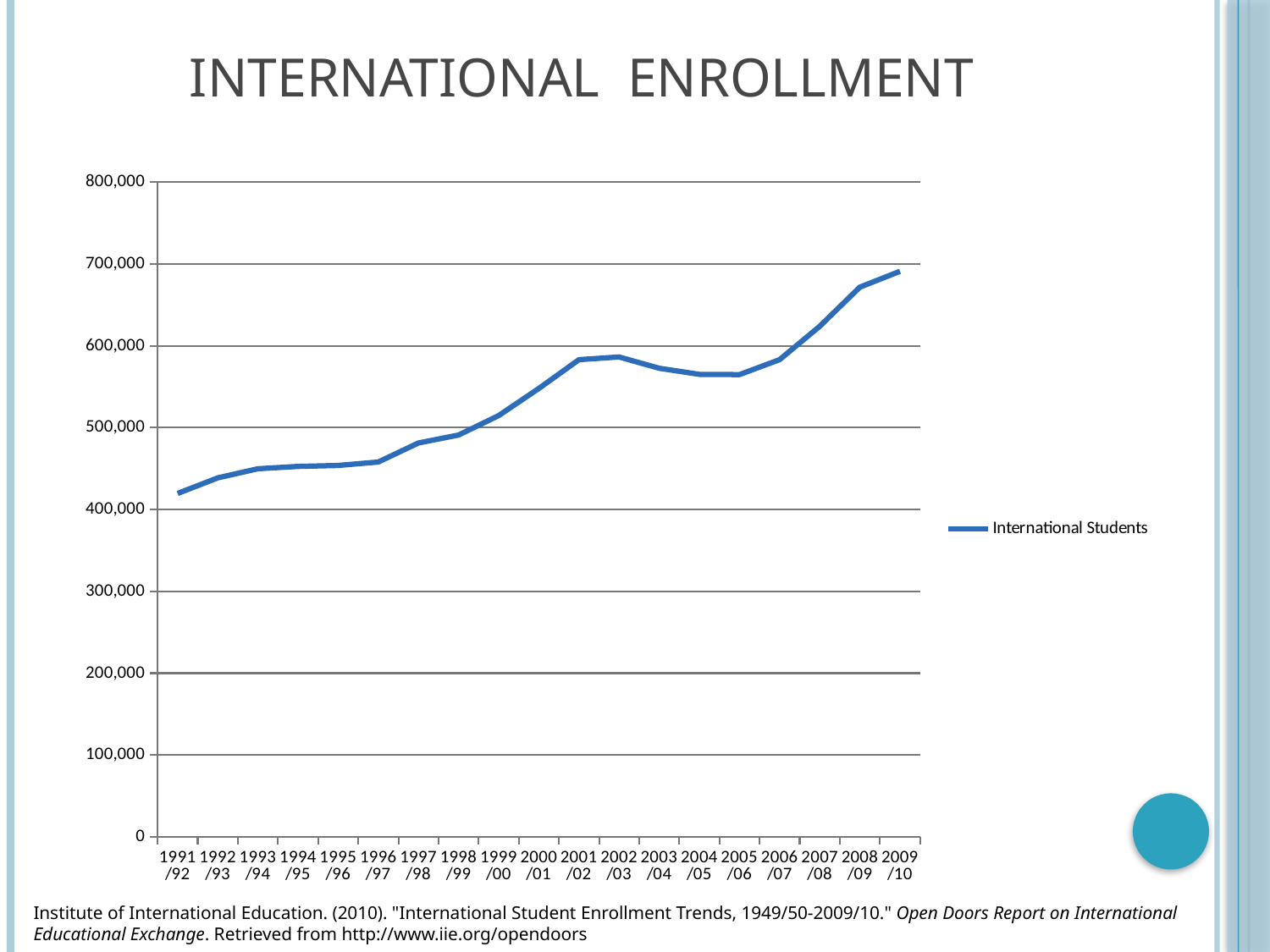
Is the value for 2009/10 greater or less than 700,000? less How many series does the legend list? 1 Is the value for 1997/98 greater or less than 500,000? less Is the value for 2001/02 greater or less than 600,000? less What is the name of the series shown in the legend? International Students Overall, do the values rise or fall from 1991/92 to 2009/10? rise What kind of chart is shown on the slide? line chart Which academic year has the lowest number of international students? 1991/92 How many academic years are plotted along the x axis? 19 Which is larger, the value for 2001/02 or the value for 1999/00? 2001/02 Which academic year has the highest number of international students? 2009/10